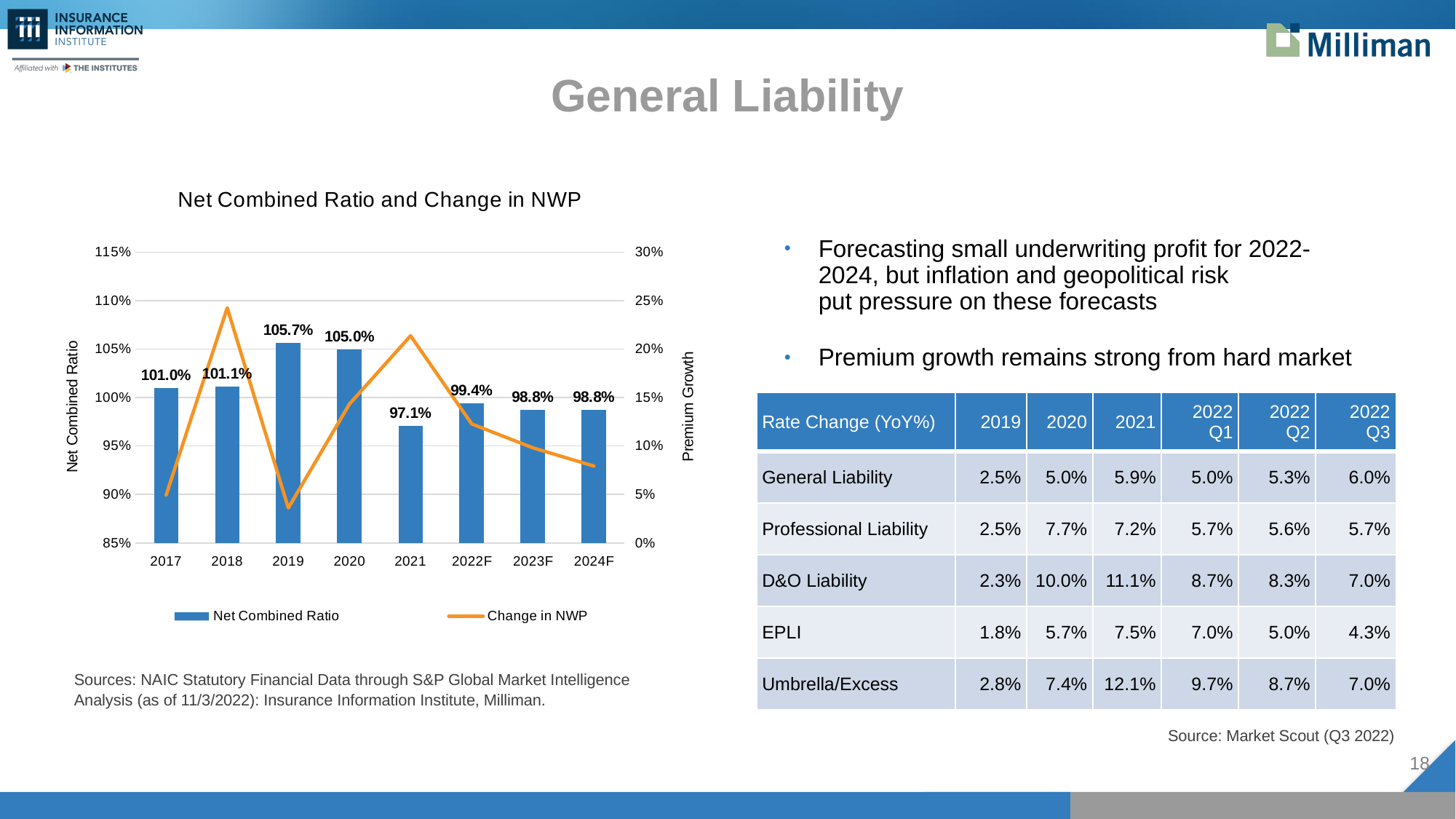
By how many percentage points does the Net Combined Ratio for 2019 exceed that for 2020? 0.7 percentage points How many years are shown on the x axis of the chart? 8 How many series does the chart legend list? 2 Which year has the lowest Net Combined Ratio in the chart? 2021 What kind of chart is used for the Net Combined Ratio and Change in NWP? Combined bar and line chart What is the Net Combined Ratio shown for 2021? 97.1% What is the Net Combined Ratio for 2019 in the Net Combined Ratio and Change in NWP chart? 105.7% What Net Combined Ratio is forecast for 2022F? 99.4% Is the Change in NWP value for 2018 greater or less than 20%? greater Which year has the highest Net Combined Ratio in the chart? 2019 Is the Change in NWP value for 2019 greater or less than 10%? less Which is larger, the Net Combined Ratio for 2020 or for 2022F? 2020